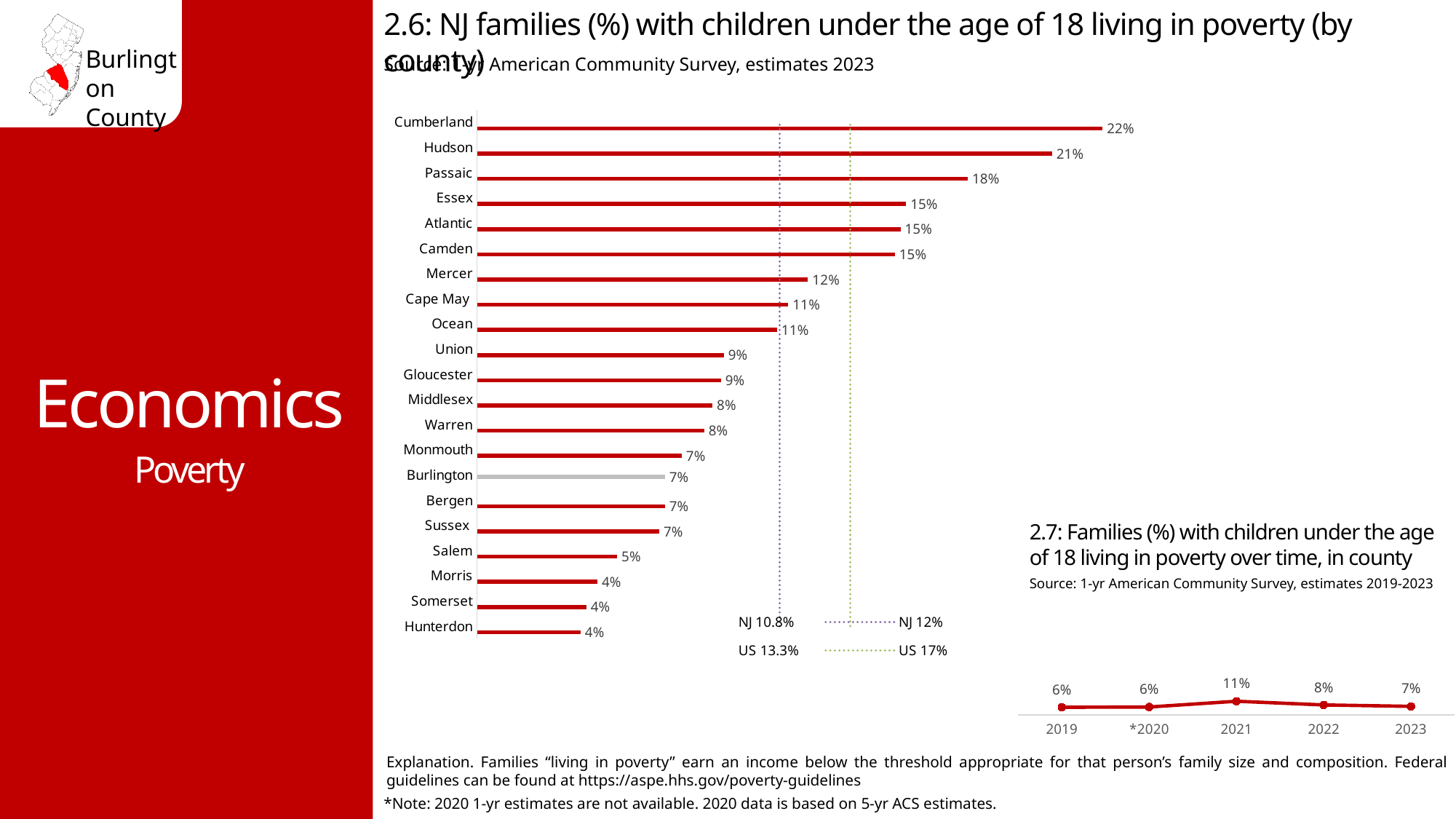
In chart 2.7, which year has the highest value? 2021 In chart 2.6 (NJ families with children under 18 living in poverty by county), what is the value for Cumberland? 22% In chart 2.7, how many data points are plotted? 5 In chart 2.6, how many counties are plotted? 21 In chart 2.6, what is the difference between the values for Hudson and Mercer? 9% In chart 2.6, which has a larger value, Passaic or Essex? Passaic What kind of chart is chart 2.6? Bar chart In chart 2.6, which county has the highest percentage of families with children living in poverty? Cumberland In chart 2.7, what is the difference between the values for 2021 and 2023? 4% In chart 2.6, what is the value for Burlington? 7% In chart 2.7 (families with children under 18 living in poverty over time, in county), what is the value for 2021? 11%